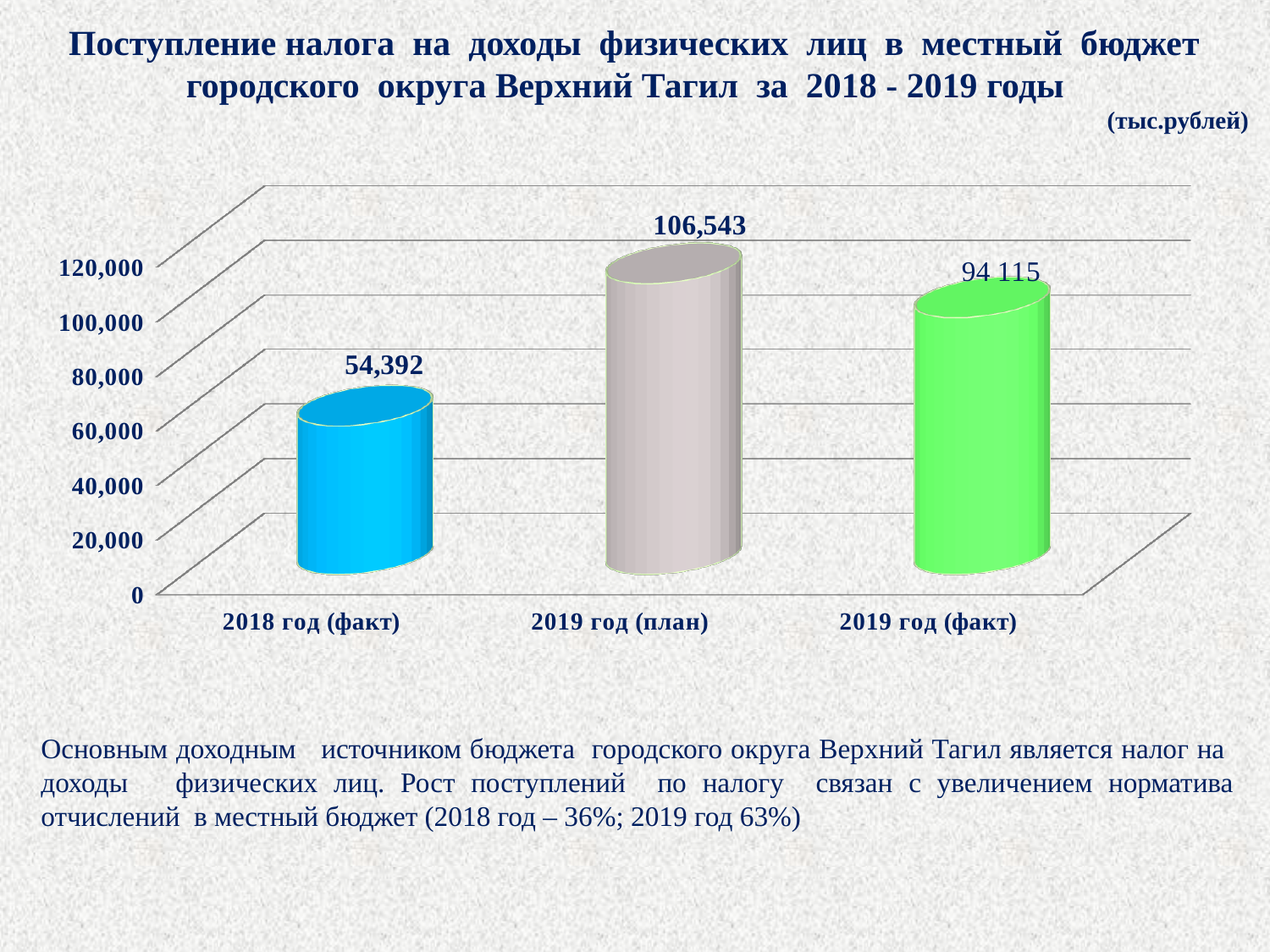
What is the value for 2019 год (факт)? 94 115 Which category has the highest value? 2019 год (план) Which is larger, the value for 2019 год (план) or the value for 2019 год (факт)? 2019 год (план) What is the difference between the values for 2019 год (факт) and 2018 год (факт)? 39,723 What is the value for 2019 год (план)? 106,543 What is the difference between the values for 2019 год (план) and 2019 год (факт)? 12,428 Which category has the lowest value? 2018 год (факт) Is the value for 2019 год (факт) greater or less than 80,000? greater What is the value for 2018 год (факт)? 54,392 In what units are the values on the chart given? тыс.рублей What kind of chart is shown on the slide? bar chart How many categories are shown on the x axis? 3